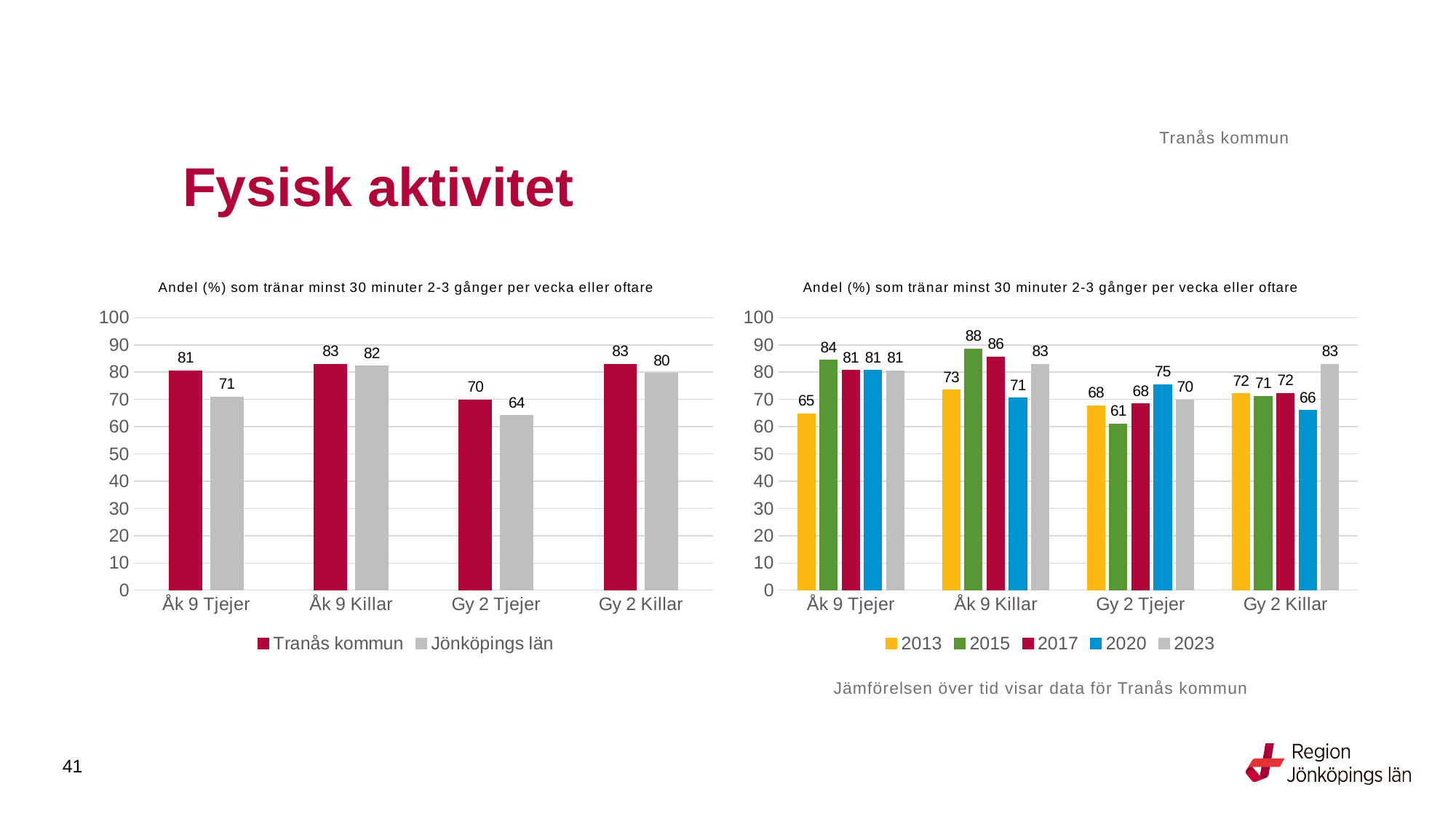
How many series does the legend of the left chart list? 2 In the left chart, what is the value for Jönköpings län for Åk 9 Tjejer? 71 In the right chart, what is the value for 2015 for Åk 9 Killar? 88 In the right chart, what is the difference between the 2023 and 2013 values for Åk 9 Tjejer? 16 In the left chart, which category has the lowest value for Jönköpings län? Gy 2 Tjejer In the left chart, what is the value for Tranås kommun for Gy 2 Tjejer? 70 What kind of chart is the right chart? Bar chart In the right chart, which is larger for Gy 2 Killar: the value for 2023 or the value for 2020? 2023 In the left chart, what is the difference between Tranås kommun and Jönköpings län for Åk 9 Tjejer? 10 How many series does the legend of the right chart list? 5 In the right chart, what is the value for 2020 for Gy 2 Killar? 66 In the right chart, which year has the lowest value for Gy 2 Tjejer? 2015